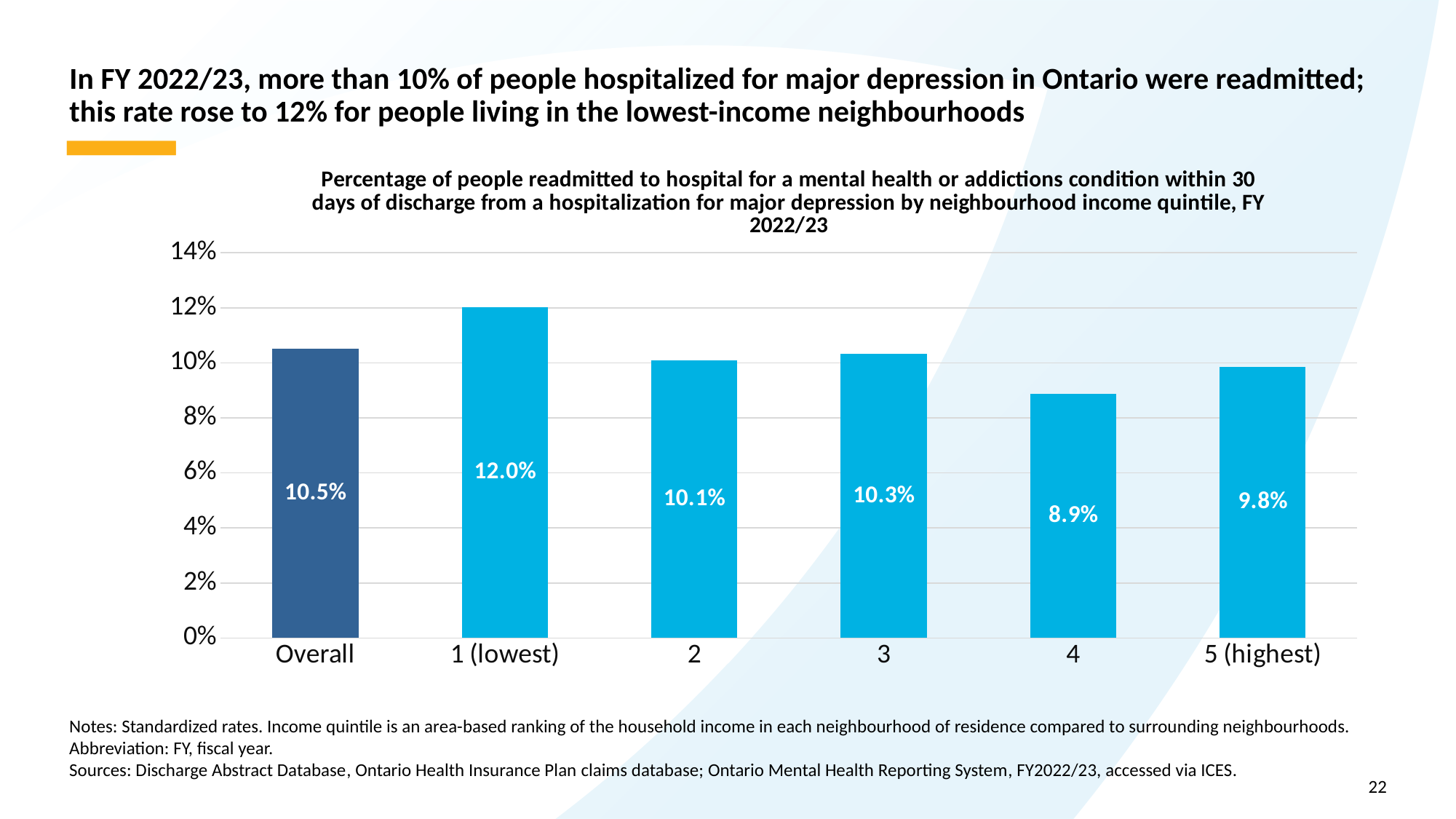
Which has a higher readmission percentage, quintile 2 or quintile 3? 3 What is the readmission percentage for income quintile 5 (highest)? 9.8% Which bar is shown in a darker blue colour than the others? Overall What is the readmission percentage for the Overall category? 10.5% Which category has the lowest readmission percentage? 4 What is the readmission percentage for income quintile 1 (lowest)? 12.0% What kind of chart is shown on the slide? Bar chart How many bars are shown in the chart? 6 Is the value for quintile 4 greater or less than 10%? less What is the difference in percentage points between quintile 1 (lowest) and quintile 5 (highest)? 2.2 What is the readmission percentage for income quintile 4? 8.9% Which category has the highest readmission percentage? 1 (lowest)